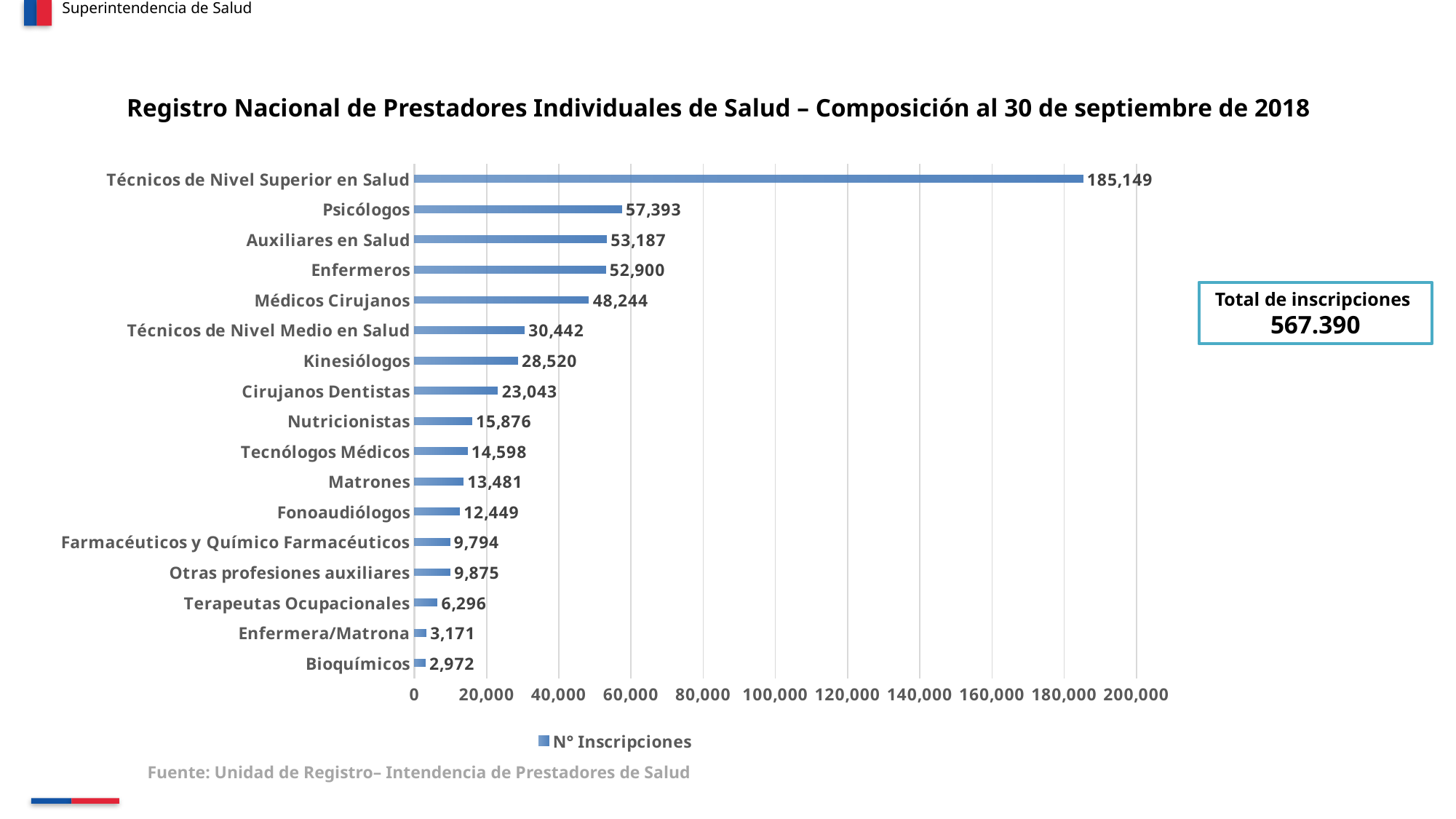
Is the value for Técnicos de Nivel Medio en Salud greater or less than 20,000? greater What kind of chart is shown on the slide? bar chart What is the value for Técnicos de Nivel Superior en Salud? 185,149 How many categories are shown in the chart? 17 What is the value for Kinesiólogos? 28,520 What is the value for Médicos Cirujanos? 48,244 What is the difference between the values for Psicólogos and Auxiliares en Salud? 4,206 What is the difference between the values for Técnicos de Nivel Superior en Salud and Psicólogos? 127,756 Which category has the lowest number of inscripciones? Bioquímicos Which is larger, the value for Enfermeros or the value for Médicos Cirujanos? Enfermeros Which category has the highest number of inscripciones? Técnicos de Nivel Superior en Salud How many series does the legend list? 1